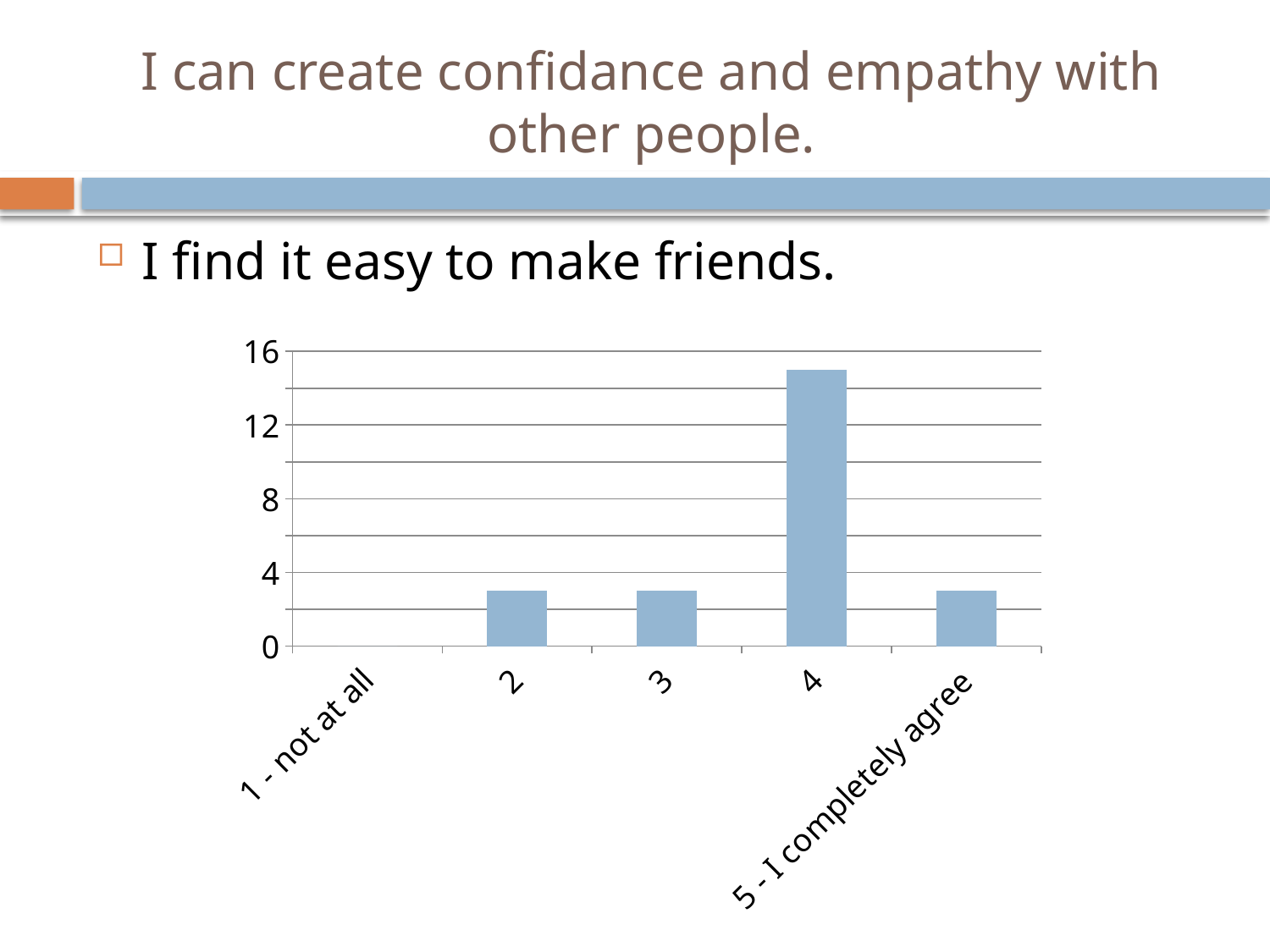
Which is larger, the value for category 4 or the value for category 3? 4 What is the label of the last category on the x axis? 5 - I completely agree Which is larger, the value for category 4 or the value for "5 - I completely agree"? 4 Is the value for category 4 greater or less than 12? greater Is the value for category 2 greater or less than 4? less Which category has the lowest value in the chart? 1 - not at all How many categories are shown on the x axis of the chart? 5 What is the highest value shown on the y axis of the chart? 16 Which category has the highest bar in the chart? 4 Is the value for "5 - I completely agree" greater or less than 8? less What is the value for the category "1 - not at all"? 0 What kind of chart is shown on the slide? bar chart